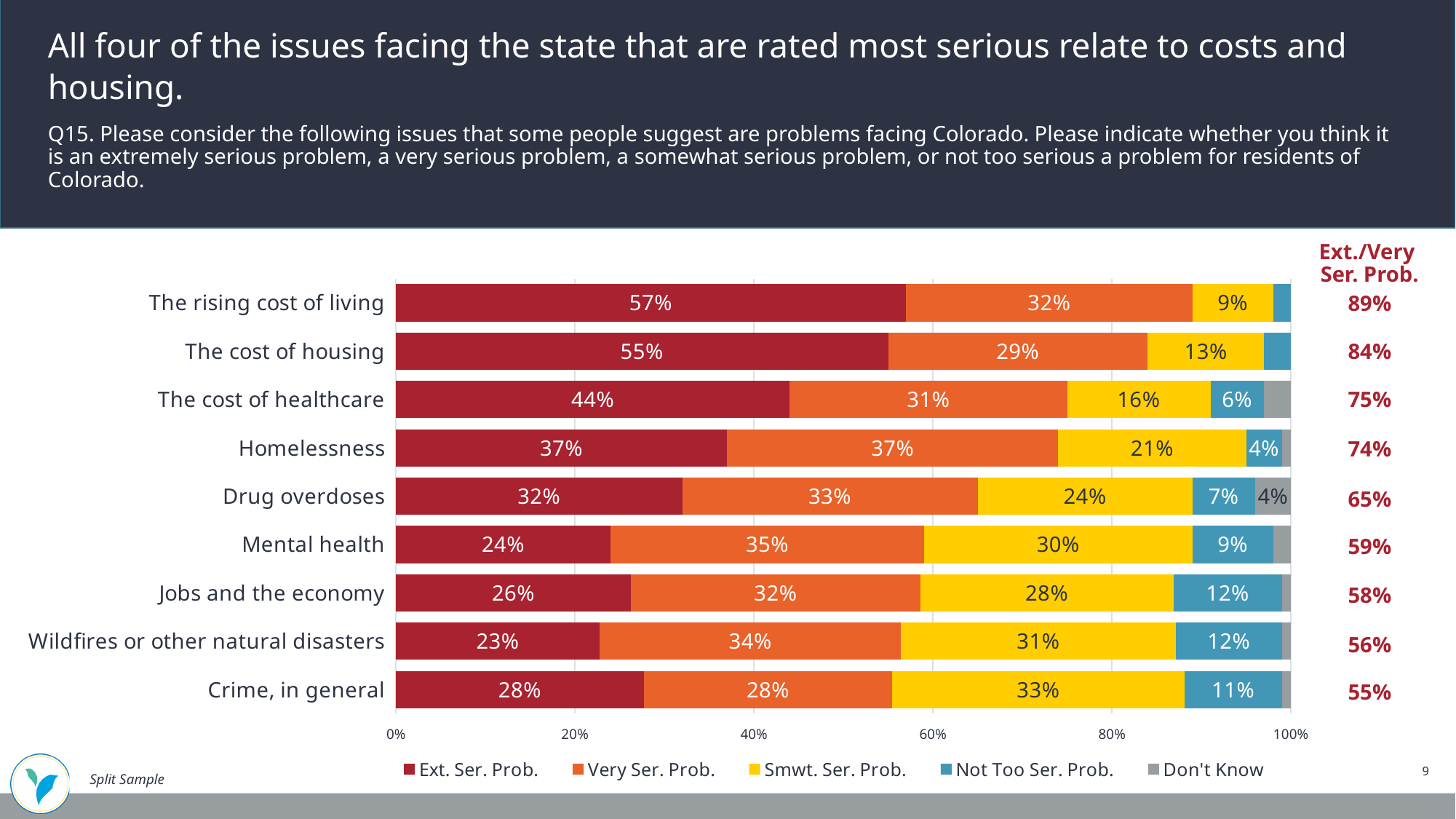
What is the difference between the Ext. Ser. Prob. values for The cost of housing and Homelessness? 18% What percentage rated the rising cost of living an extremely serious problem (Ext. Ser. Prob.)? 57% What type of chart is shown on the slide? Stacked bar chart Which has a larger Very Ser. Prob. value: Drug overdoses or Crime, in general? Drug overdoses Which issue has the lowest Ext. Ser. Prob. percentage? Wildfires or other natural disasters What is the Not Too Ser. Prob. value for Jobs and the economy? 12% Which issue has the highest Ext. Ser. Prob. percentage? The rising cost of living What is the Smwt. Ser. Prob. value for Mental health? 30% How many issues are listed in the chart? 9 How many series does the legend list? 5 Which legend entry is shown in yellow? Smwt. Ser. Prob. What is the combined Ext./Very Ser. Prob. figure shown for The cost of healthcare? 75%